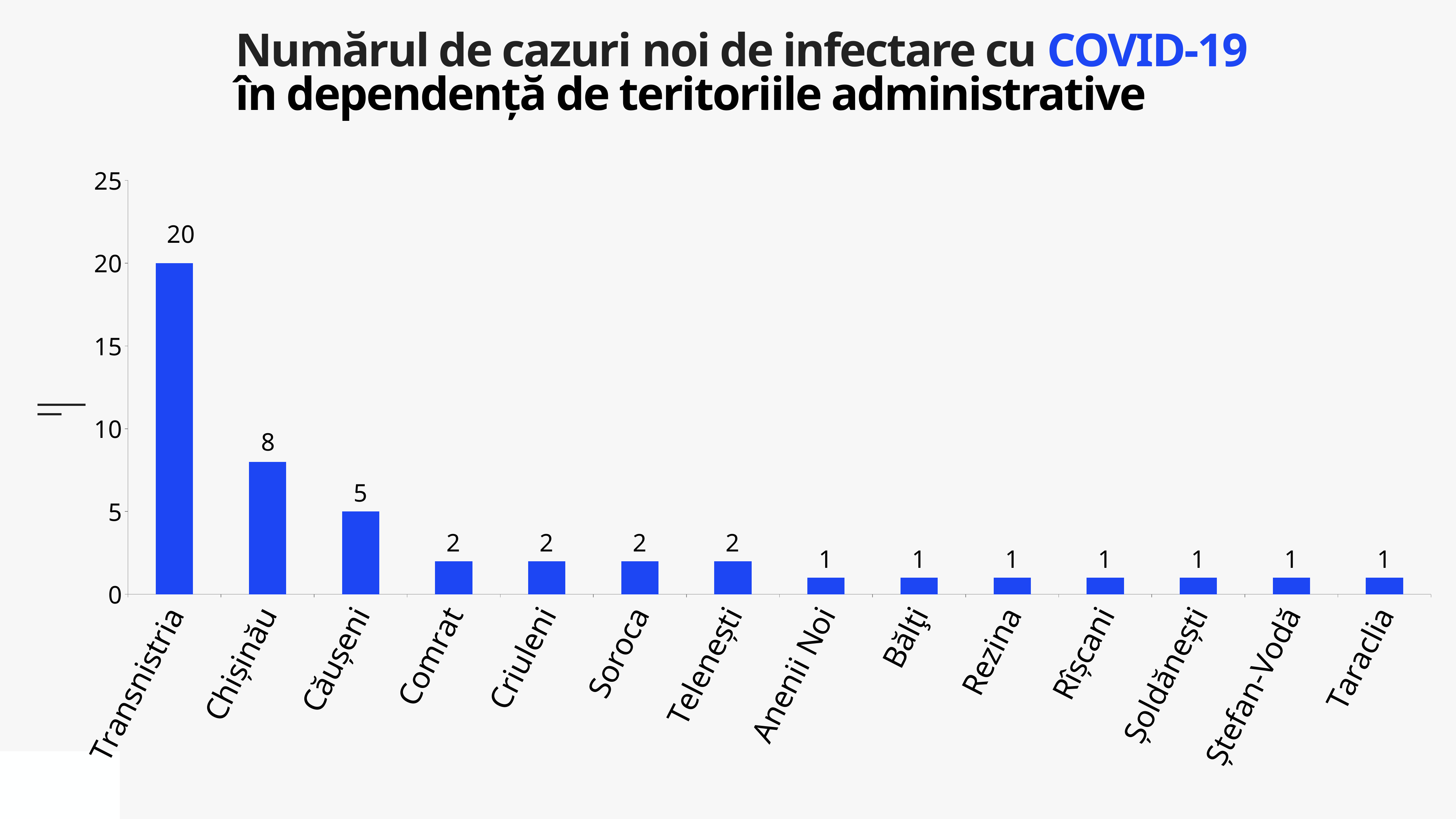
What is the value for Taraclia? 1 What is the value for Transnistria? 20 What is the difference between the values for Chișinău and Căușeni? 3 Which is larger, the value for Căușeni or the value for Comrat? Căușeni Is the value for Transnistria greater or less than 15? greater What is the value for Chișinău? 8 What is the value for Căușeni? 5 How many territories are shown on the chart? 14 What kind of chart is shown on the slide? Bar chart What is the difference between the values for Transnistria and Chișinău? 12 Which territory has the highest number of new cases? Transnistria What is the value for Soroca? 2